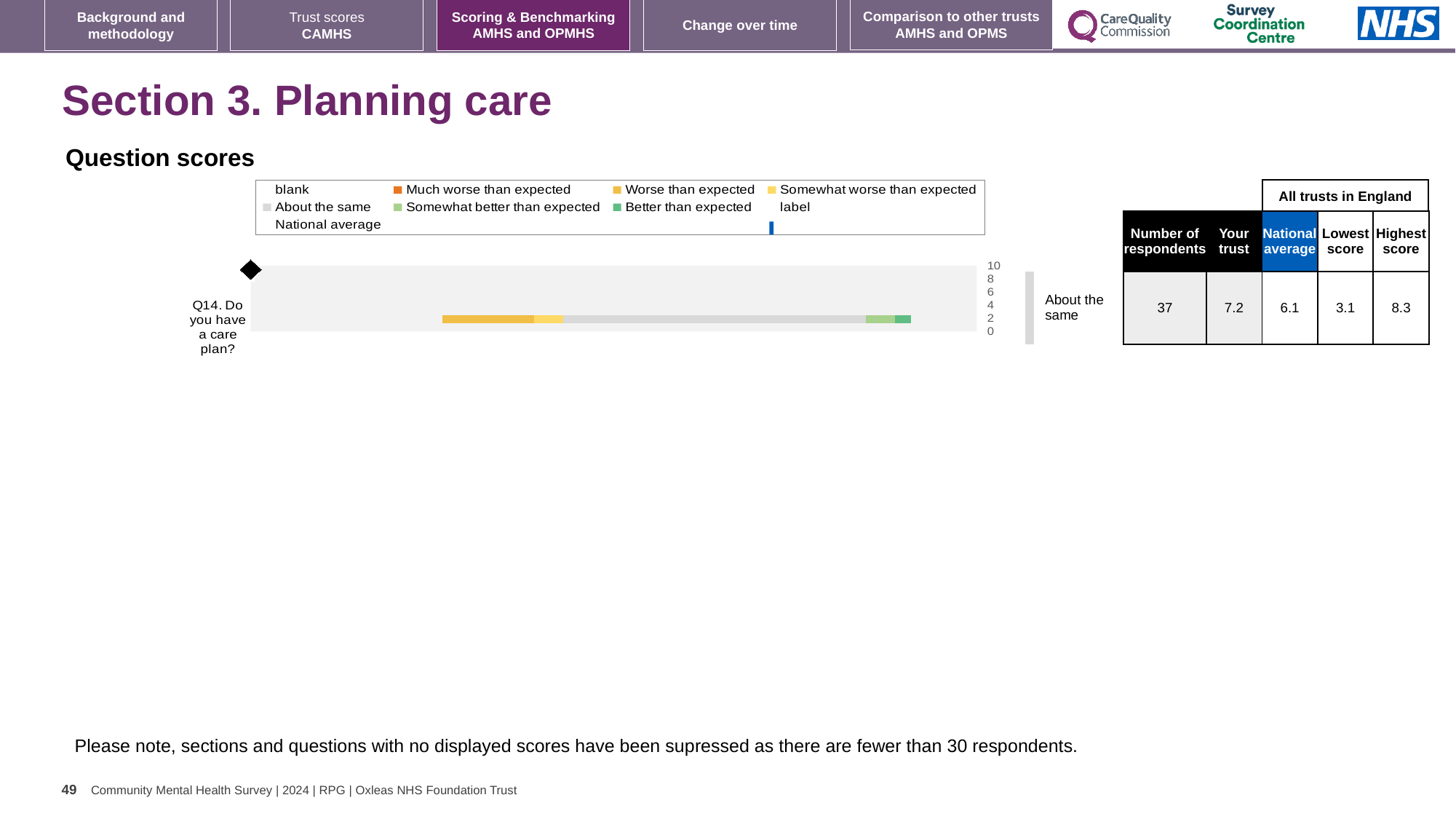
In the table beside the chart, what is the national average score for Q14? 6.1 What benchmark category label is shown to the right of the Q14 bar? About the same In the table beside the chart, what is the lowest score among all trusts in England for Q14? 3.1 In the table beside the chart, what is the number of respondents for Q14? 37 Which question is plotted in the Question scores chart? Q14. Do you have a care plan? What kind of chart is used to show the Q14 question score? Bar chart In the table beside the chart, what is the highest score among all trusts in England for Q14? 8.3 By how much does the 'Your trust' score for Q14 exceed the national average? 1.1 What is the difference between the highest score and the lowest score for Q14 in the table? 5.2 How many questions are plotted in the Question scores chart? 1 In the table beside the chart, what is the 'Your trust' score for Q14? 7.2 For Q14, which is larger: the 'Your trust' score or the national average? Your trust